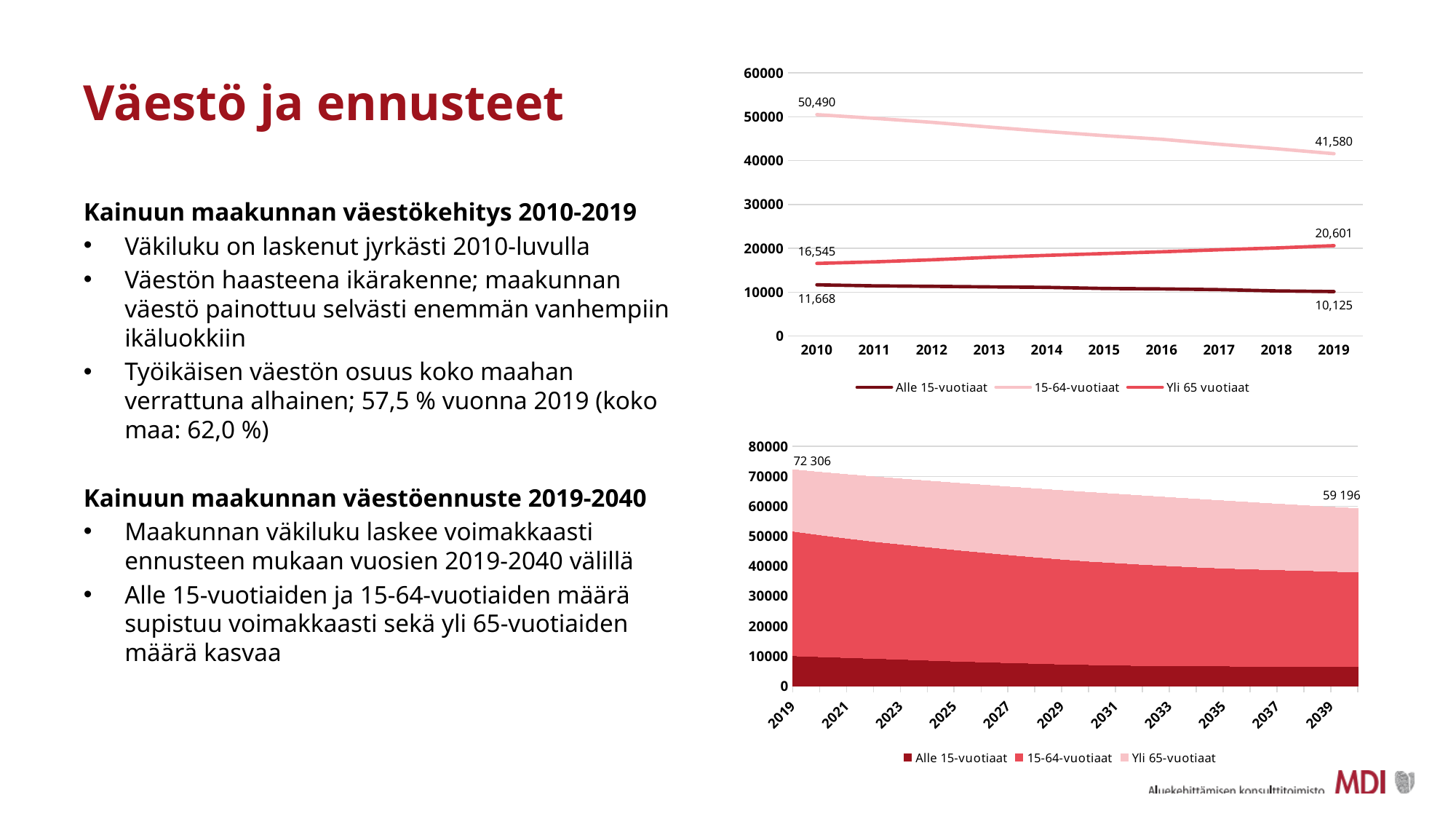
In the top chart, what is the value for Alle 15-vuotiaat in 2010? 11,668 In the top chart, what is the value for 15-64-vuotiaat in 2010? 50,490 How many series does the legend of the top chart list? 3 In the top chart, does the Yli 65 vuotiaat series rise or fall from 2010 to 2019? rise In the top chart, what is the value for Yli 65 vuotiaat in 2019? 20,601 In the top chart, by how much did the 15-64-vuotiaat series fall from 2010 to 2019? 8,910 In the top chart, which series has the highest value in 2019? 15-64-vuotiaat In the bottom chart, what is the total population shown for 2019? 72 306 In the bottom chart, is the total value at the end of the forecast greater or less than 60000? less In the top chart, what is the value for 15-64-vuotiaat in 2019? 41,580 What kind of chart is the top chart? line chart In the top chart, by how much did the Yli 65 vuotiaat series grow from 2010 to 2019? 4,056